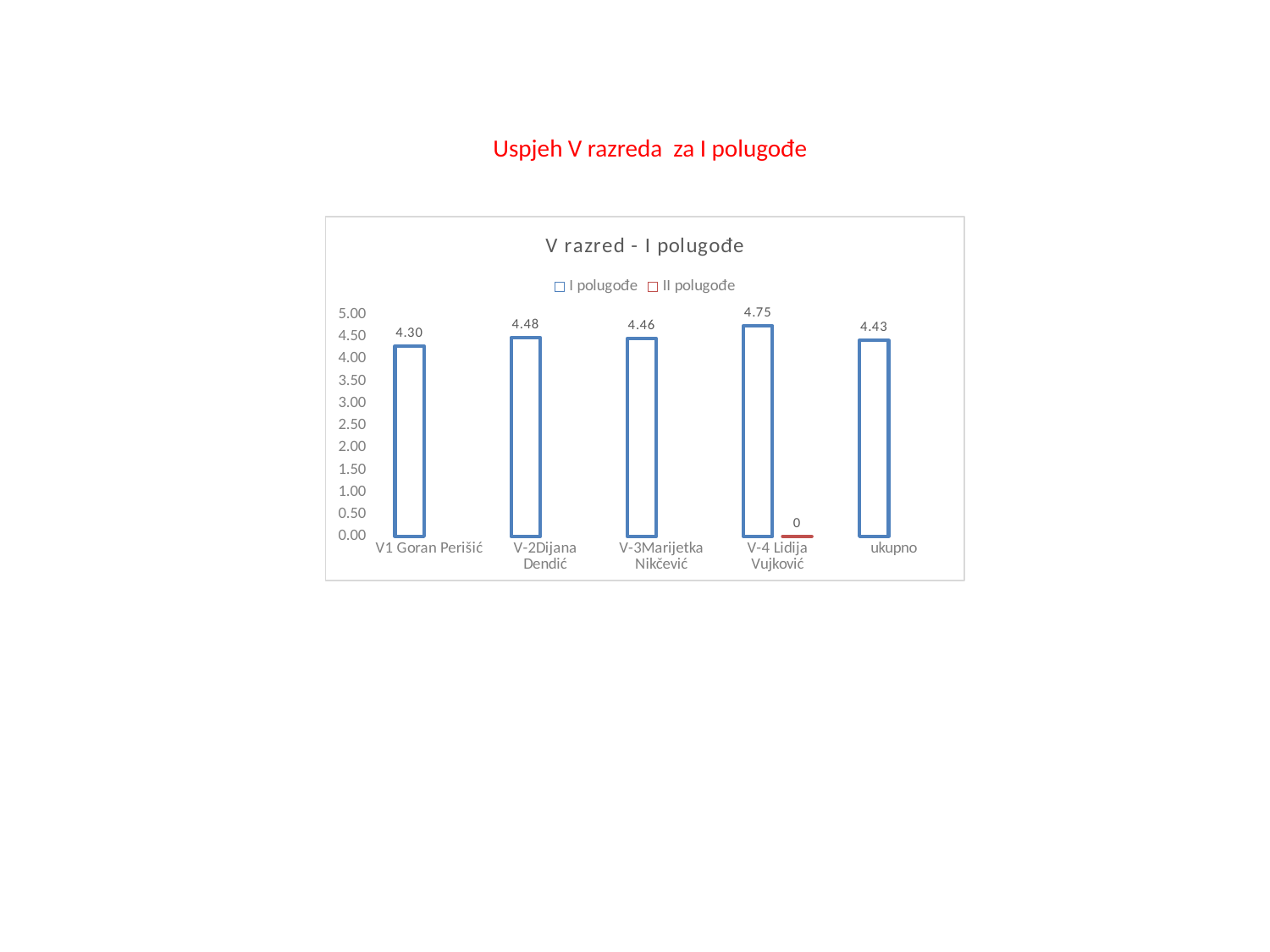
What is the difference between the I polugođe values for V-4 Lidija Vujković and V1 Goran Perišić? 0.45 What is the I polugođe value for V-3 Marijetka Nikčević? 4.46 How many series does the legend list? 2 Which is larger, the I polugođe value for V-2 Dijana Dendić or for ukupno? V-2 Dijana Dendić How many categories are shown on the x axis? 5 Which category has the lowest I polugođe value? V1 Goran Perišić What kind of chart is shown? Bar chart Which category has the highest I polugođe value? V-4 Lidija Vujković What is the title of the chart? V razred - I polugođe What is the I polugođe value for V1 Goran Perišić? 4.30 What is the I polugođe value for ukupno? 4.43 What is the I polugođe value for V-2 Dijana Dendić? 4.48